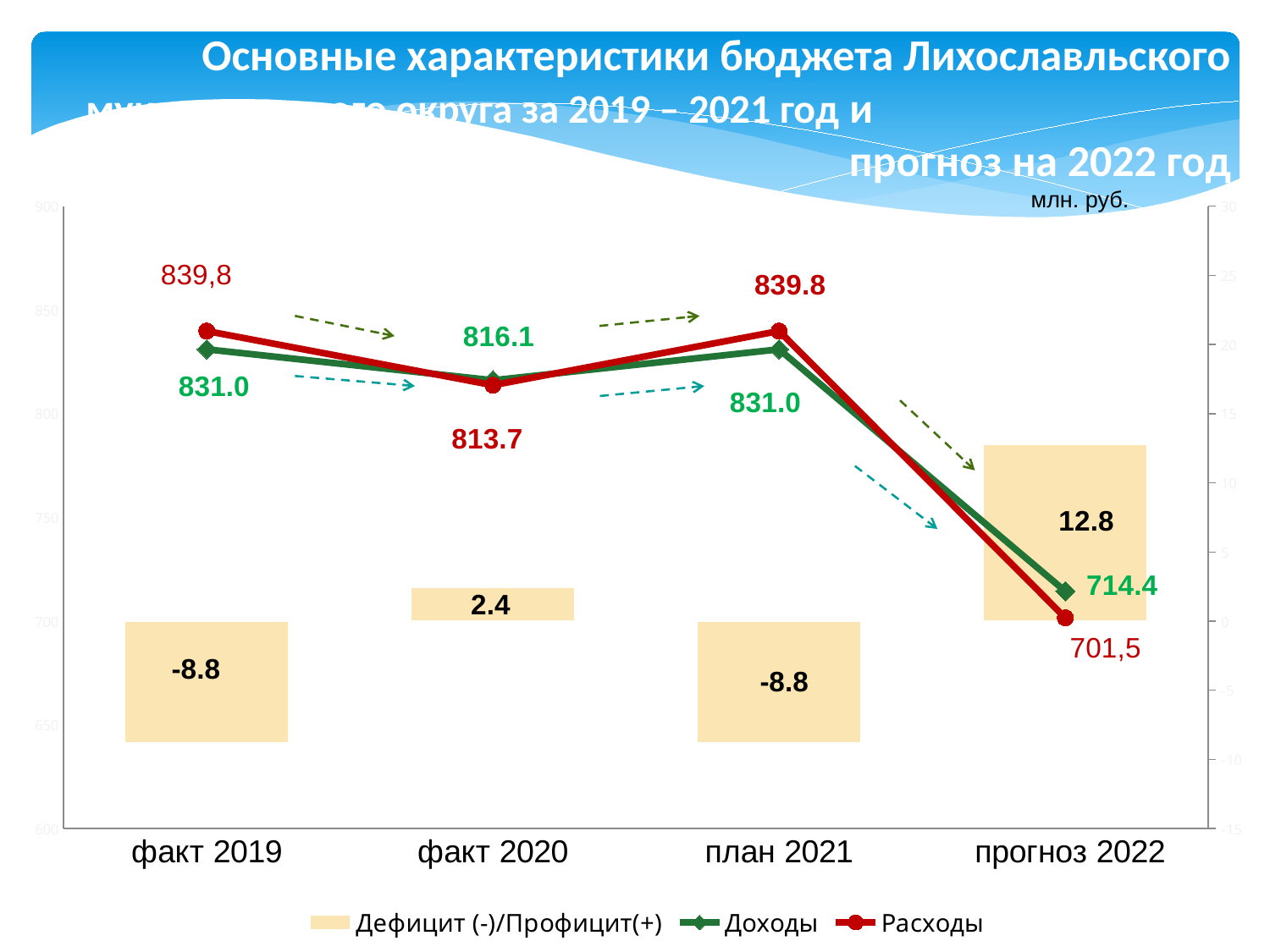
What is the difference between Расходы and Доходы for факт 2020? 2.4 What is the value of Доходы for факт 2020? 816.1 How many categories are shown on the x axis? 4 What unit is stated above the chart? млн. руб. What is the value of Дефицит (-)/Профицит(+) for прогноз 2022? 12.8 Which is larger for факт 2019: Доходы or Расходы? Расходы How many series does the legend list? 3 Does the Доходы series rise or fall from план 2021 to прогноз 2022? fall Which category has the highest value of Дефицит (-)/Профицит(+)? прогноз 2022 Which category has the lowest value of Доходы? прогноз 2022 What is the value of Расходы for план 2021? 839.8 What is the value of Расходы for прогноз 2022? 701,5